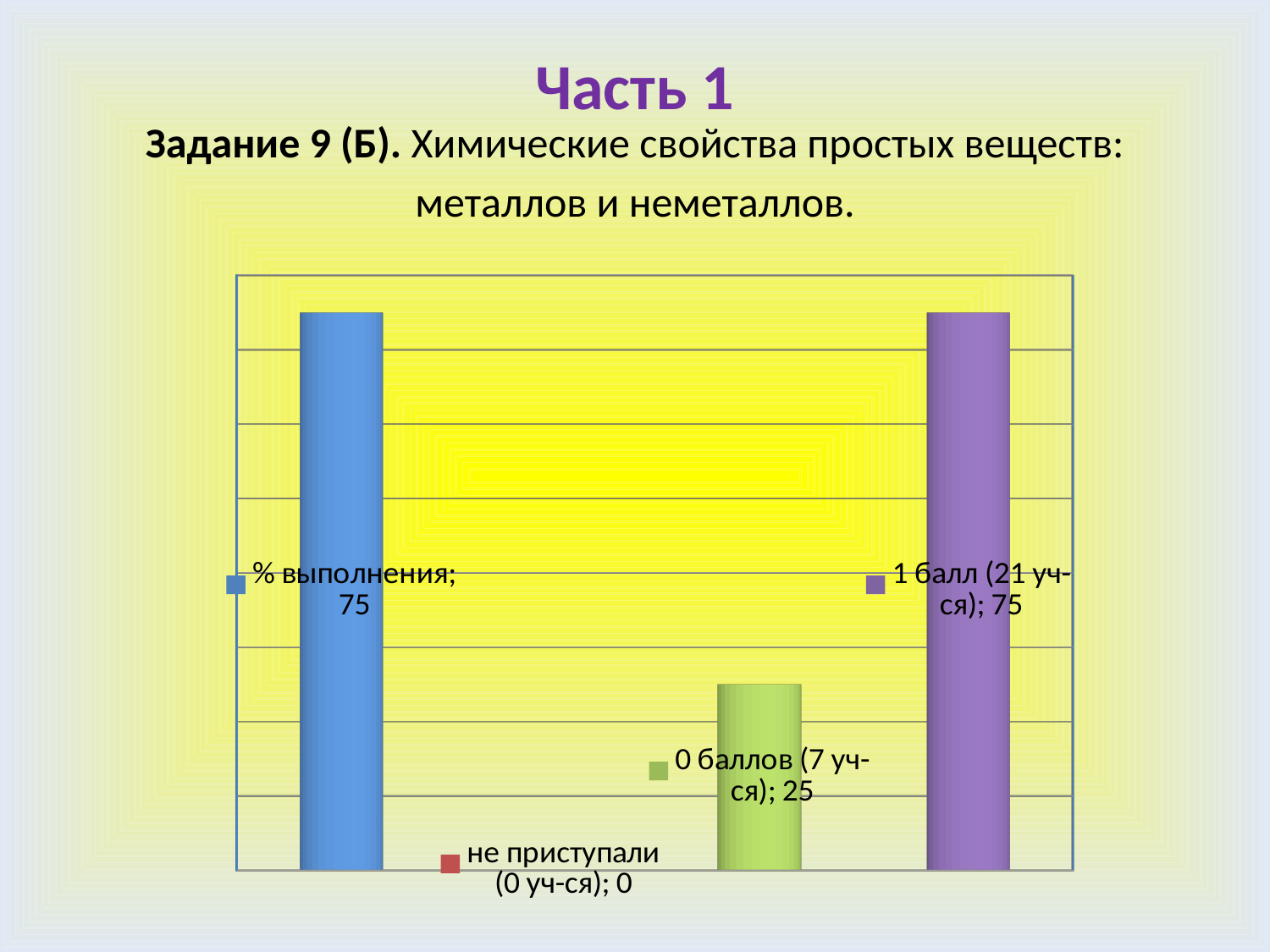
Which is larger: the value for "0 баллов (7 уч-ся)" or the value for "1 балл (21 уч-ся)"? 1 балл (21 уч-ся) What is the value for "не приступали (0 уч-ся)"? 0 What is the difference between the values for "1 балл (21 уч-ся)" and "0 баллов (7 уч-ся)"? 50 What is the value for "1 балл (21 уч-ся)"? 75 What kind of chart is shown on the slide? bar chart How many students scored 1 балл according to the data label? 21 What is the title of the slide above the chart? Часть 1 What is the value for "% выполнения"? 75 How many bars (categories) does the chart show? 4 Which category has the lowest value? не приступали (0 уч-ся) What is the value for "0 баллов (7 уч-ся)"? 25 What colour is the bar for "0 баллов (7 уч-ся)"? green